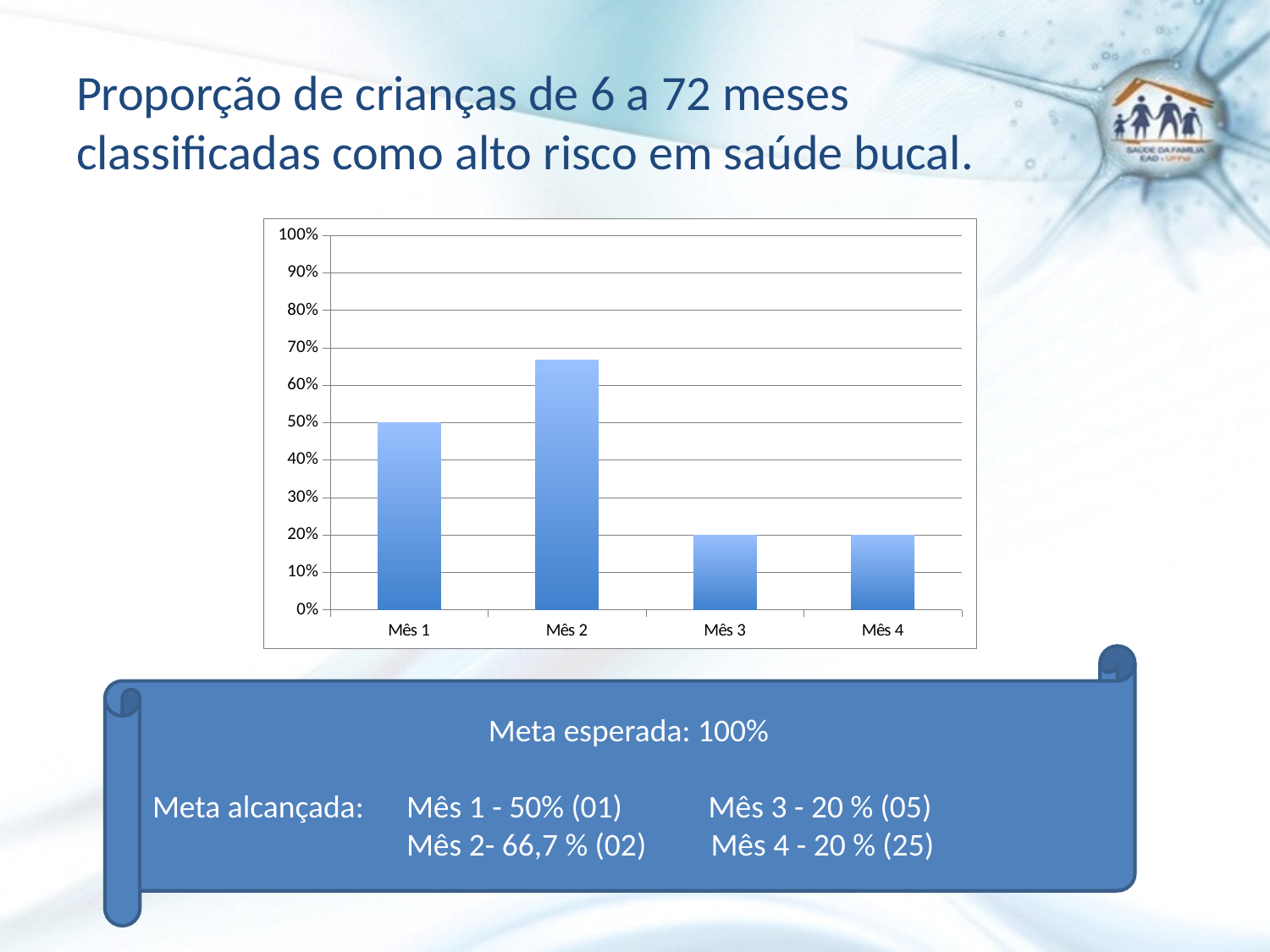
What is the value for Mês 3? 20 % How many categories (months) are shown on the x axis of the chart? 4 Is the value for Mês 2 greater or less than 60%? greater What type of chart is shown on the slide? bar chart Which of Mês 1 and Mês 4 has the larger value? Mês 1 Is the value for Mês 3 greater or less than 30%? less Which month has the highest value in the chart? Mês 2 Do the values rise or fall from Mês 2 to Mês 3? fall What is the value for Mês 1? 50% What is the expected target (meta esperada) stated on the slide? 100% What is the difference between the values for Mês 1 and Mês 3? 30% What is the value for Mês 2? 66,7 %